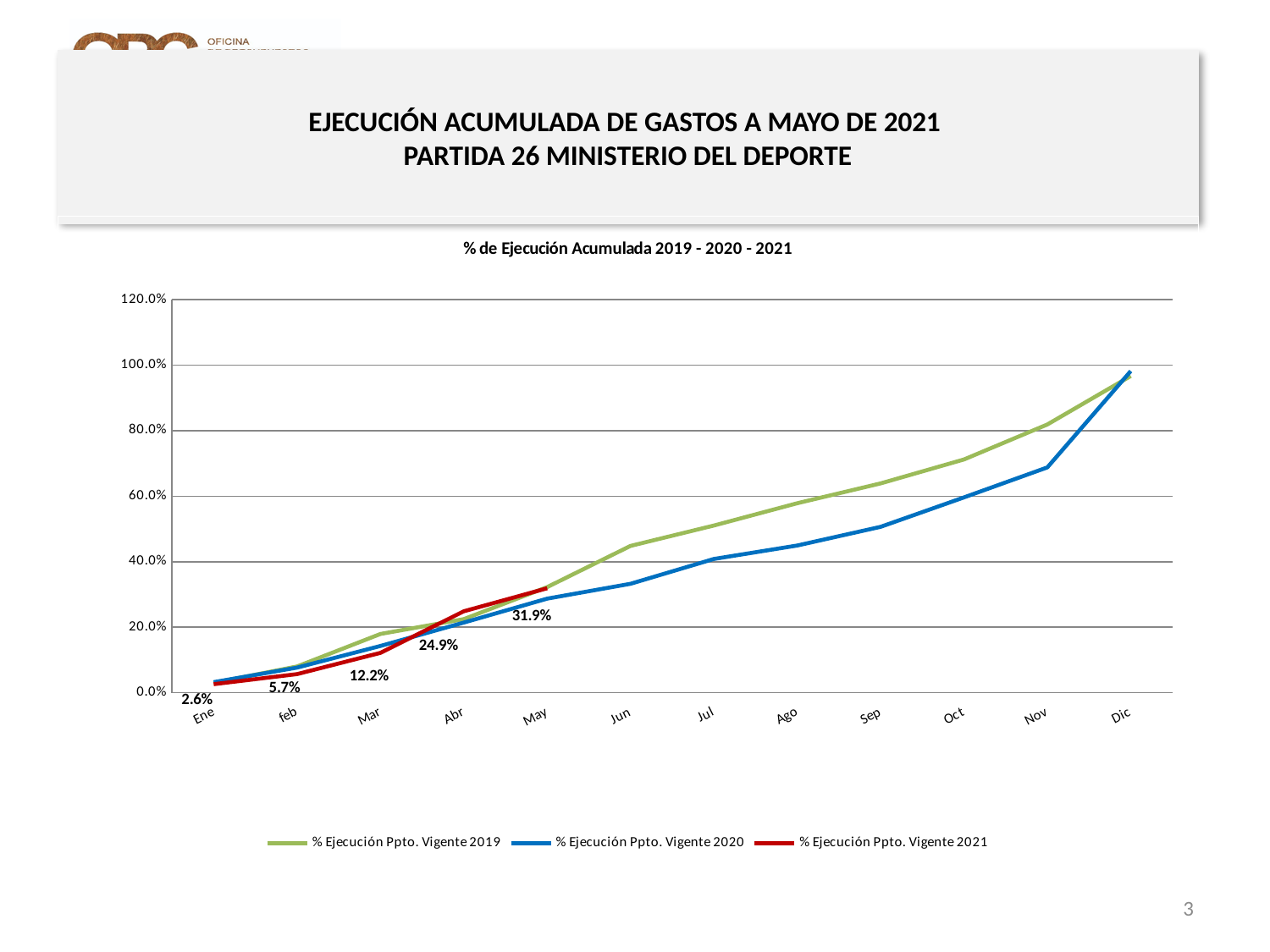
What is the difference between the 2021 values for Mar and feb? 6.5% How many months are shown on the x axis? 12 What is the value of % Ejecución Ppto. Vigente 2021 in May? 31.9% In which month does the % Ejecución Ppto. Vigente 2021 series reach its highest value? May How many series does the legend list? 3 What is the value of % Ejecución Ppto. Vigente 2021 in Abr? 24.9% Is the value for % Ejecución Ppto. Vigente 2020 in Nov greater or less than 80.0%? less What colour is the line for % Ejecución Ppto. Vigente 2021? Red Which series has the higher value in Oct, % Ejecución Ppto. Vigente 2019 or % Ejecución Ppto. Vigente 2020? % Ejecución Ppto. Vigente 2019 What is the value of % Ejecución Ppto. Vigente 2021 in Ene? 2.6% What is the difference between the 2021 values for May and Abr? 7.0% What kind of chart is shown on the slide? Line chart